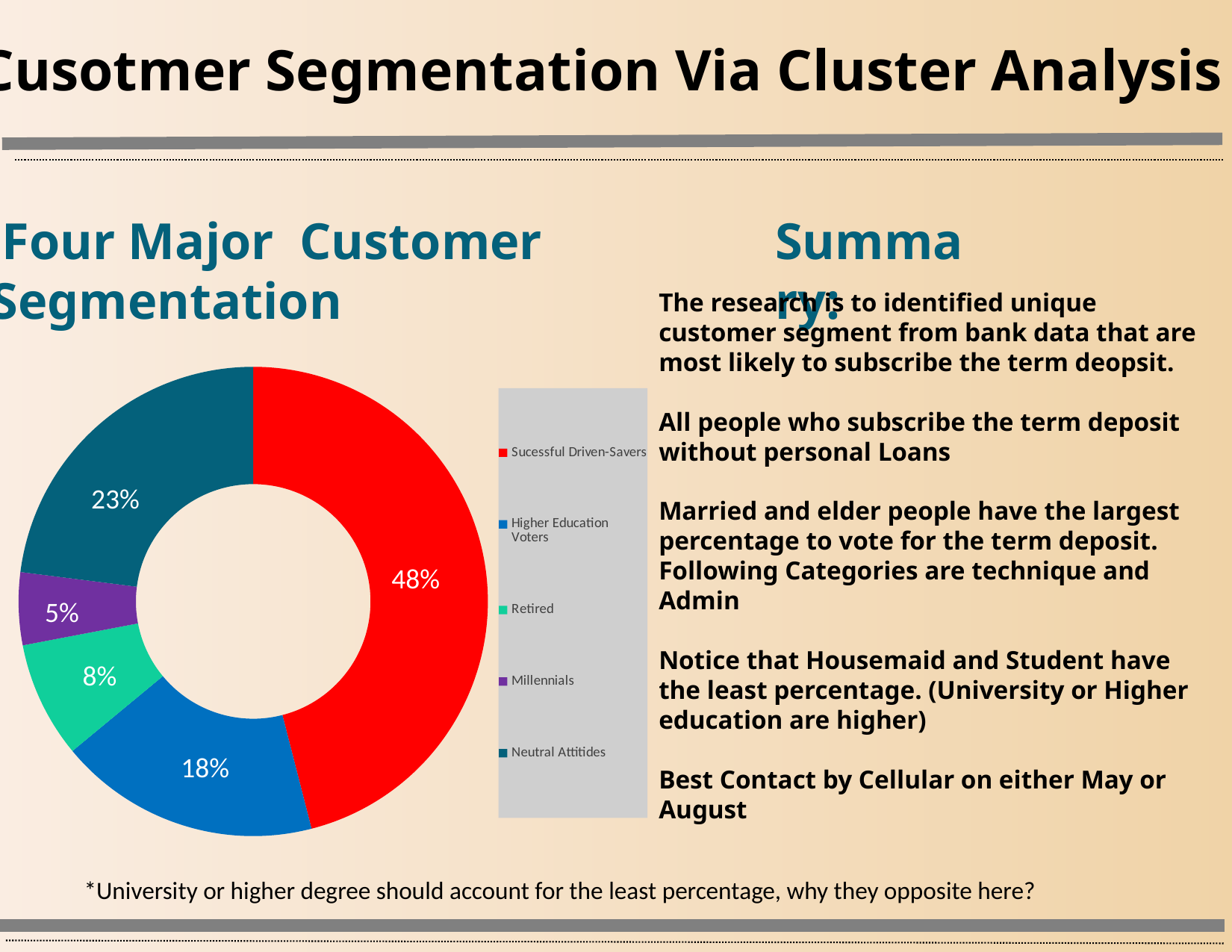
What percentage of the doughnut chart is Sucessful Driven-Savers? 48% Which segment has the smallest share in the doughnut chart? Millennials What is the difference in percentage points between Sucessful Driven-Savers and Neutral Attitides? 25 Which segment has the largest share in the doughnut chart? Sucessful Driven-Savers What kind of chart is shown on the slide? doughnut chart What percentage of the doughnut chart is Neutral Attitides? 23% What colour is the Sucessful Driven-Savers segment in the chart? red Which is larger, the Retired share or the Millennials share? Retired What percentage of the doughnut chart is Retired? 8% How many segments does the doughnut chart have? 5 What percentage of the doughnut chart is Higher Education Voters? 18% What percentage of the doughnut chart is Millennials? 5%